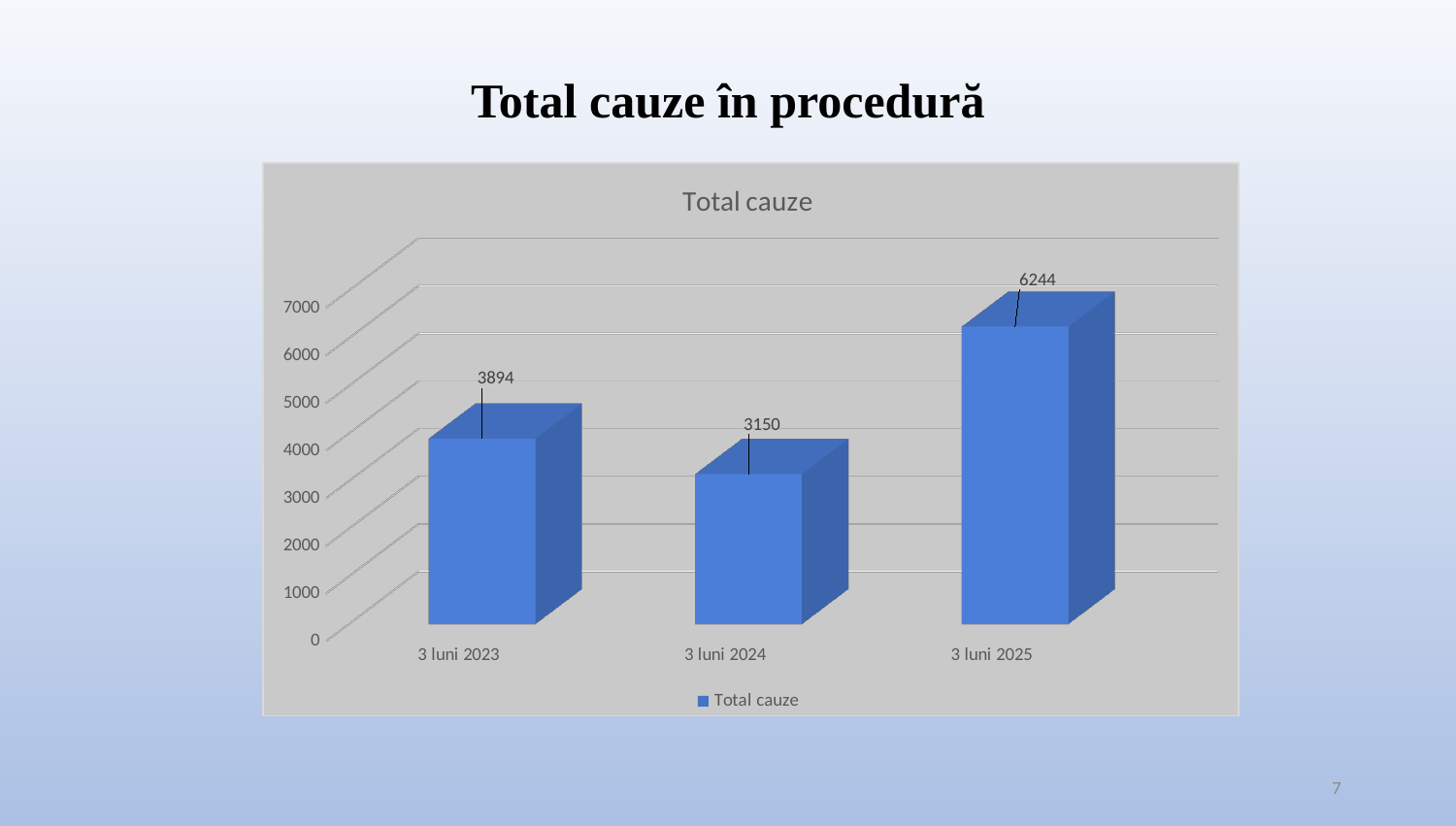
Which category has the lowest value? 3 luni 2024 What kind of chart is shown? bar chart Which category has the highest value? 3 luni 2025 What is the difference between the values for 3 luni 2023 and 3 luni 2024? 744 What is the value for 3 luni 2025? 6244 What is the value for 3 luni 2024? 3150 Which is larger, the value for 3 luni 2023 or the value for 3 luni 2024? 3 luni 2023 What is the value for 3 luni 2023? 3894 What is the title of the chart? Total cauze Is the value for 3 luni 2025 greater or less than 5000? greater What is the difference between the values for 3 luni 2025 and 3 luni 2023? 2350 How many categories are shown on the x axis? 3